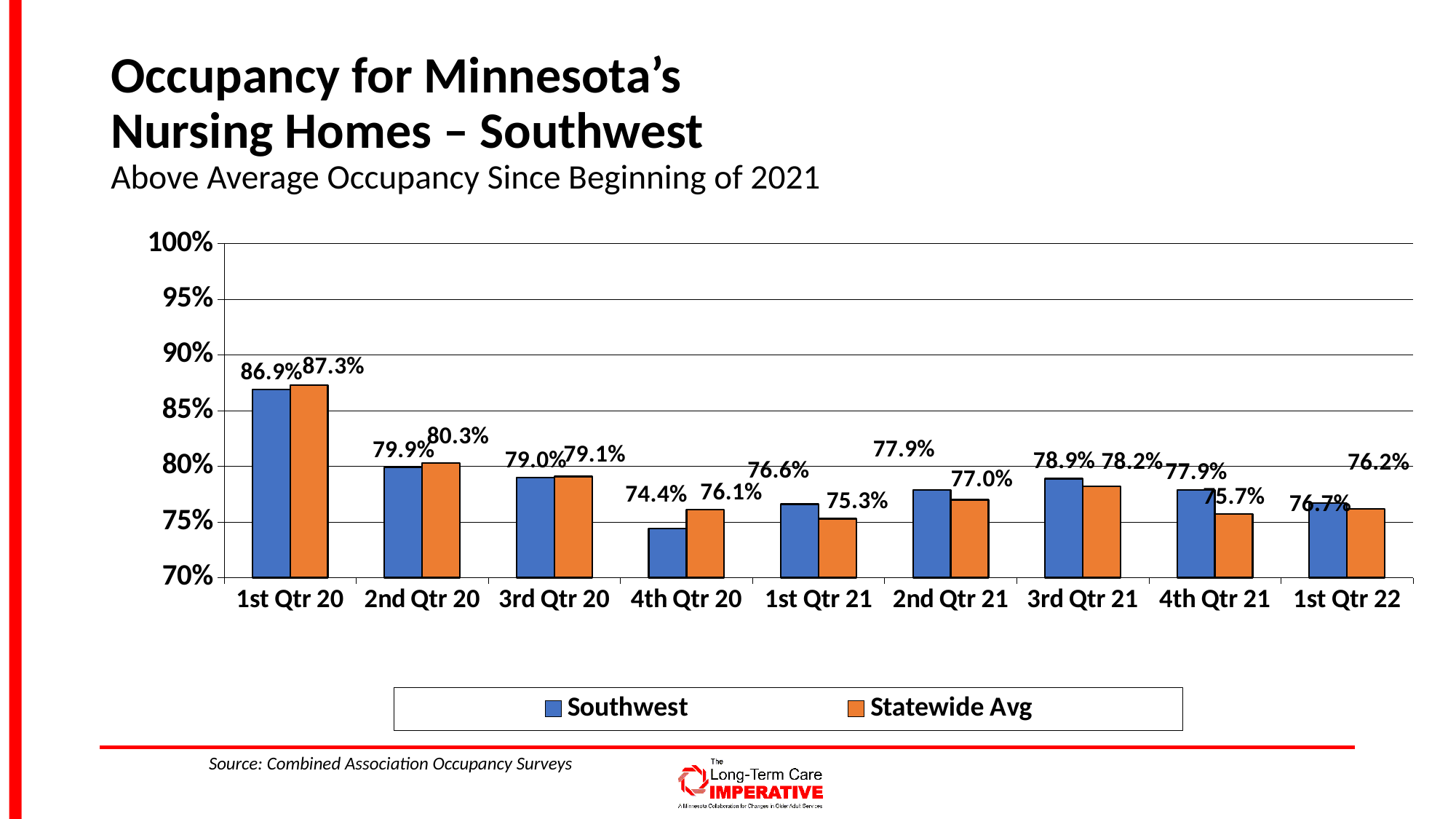
In 4th Qtr 21, which is larger: the Southwest value or the Statewide Avg value? Southwest What is the Statewide Avg occupancy value for 1st Qtr 22? 76.2% In which quarter is the Southwest occupancy highest? 1st Qtr 20 What is the difference between the Statewide Avg and Southwest values in 4th Qtr 21? 2.2% Which colour represents the Statewide Avg series? Orange In 1st Qtr 20, which is larger: the Southwest value or the Statewide Avg value? Statewide Avg What kind of chart is shown on the slide? Bar chart What is the Southwest occupancy value for 4th Qtr 20? 74.4% What is the Southwest occupancy value for 3rd Qtr 21? 78.9% How many quarters are shown on the x axis? 9 In which quarter is the Southwest occupancy lowest? 4th Qtr 20 How many series does the legend list? 2